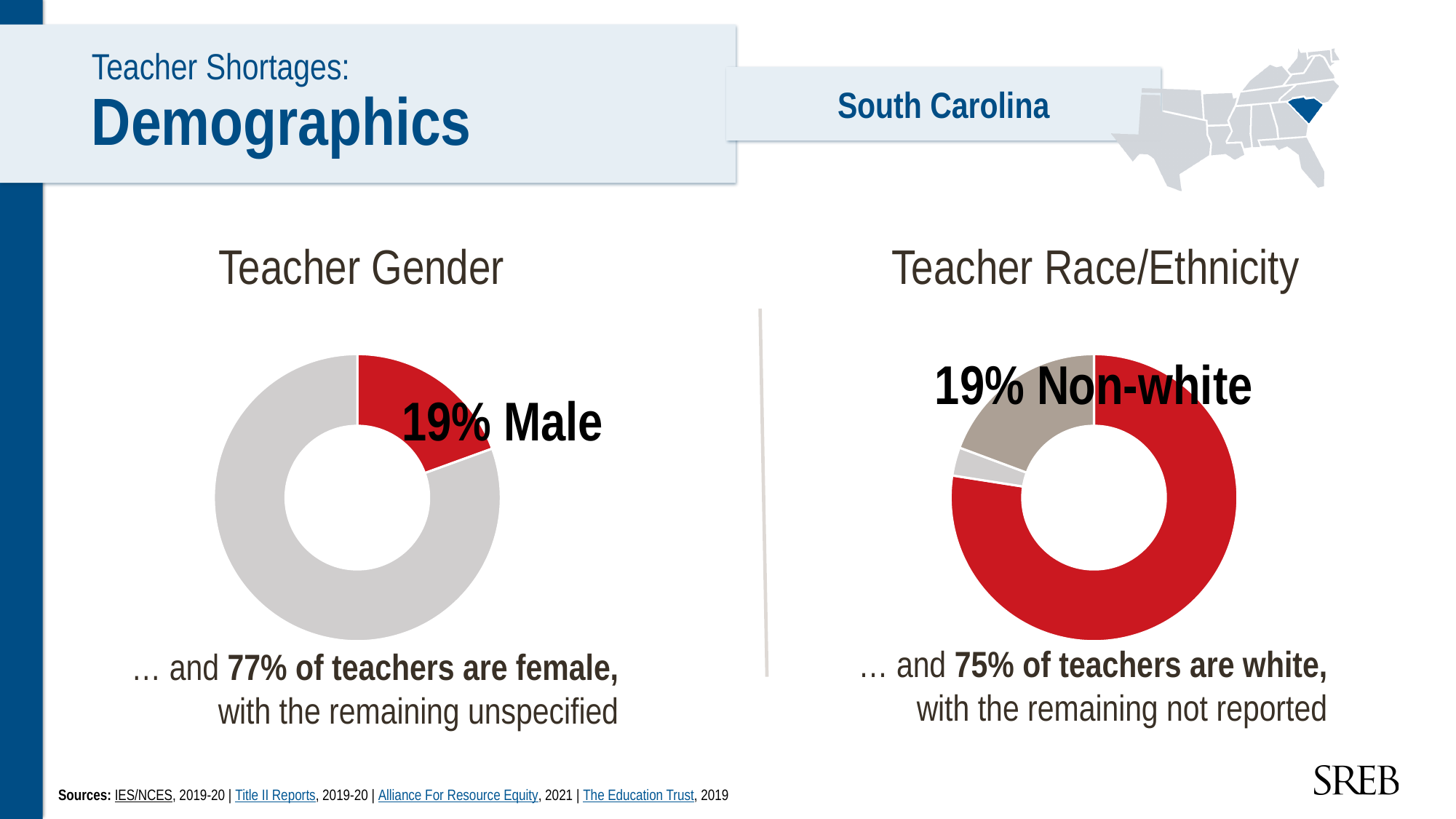
In the Teacher Gender chart, what is the difference in percentage points between female and male teachers? 58 percentage points In the Teacher Gender chart, what percentage of teachers are male? 19% In the Teacher Race/Ethnicity chart, which group is larger, white or non-white teachers? White In the Teacher Race/Ethnicity chart, what percentage of teachers are white? 75% What kind of chart is used for Teacher Gender? Donut chart Which state do the charts on this slide describe? South Carolina In the Teacher Race/Ethnicity chart, what is the difference in percentage points between white and non-white teachers? 56 percentage points In the Teacher Gender chart, what share of teachers have unspecified gender? 4% In the Teacher Gender chart, what percentage of teachers are female? 77% In the Teacher Race/Ethnicity chart, what percentage of teachers are non-white? 19% In the Teacher Gender chart, which group is larger, male or female teachers? Female In the Teacher Gender chart, what colour is the slice representing male teachers? Red